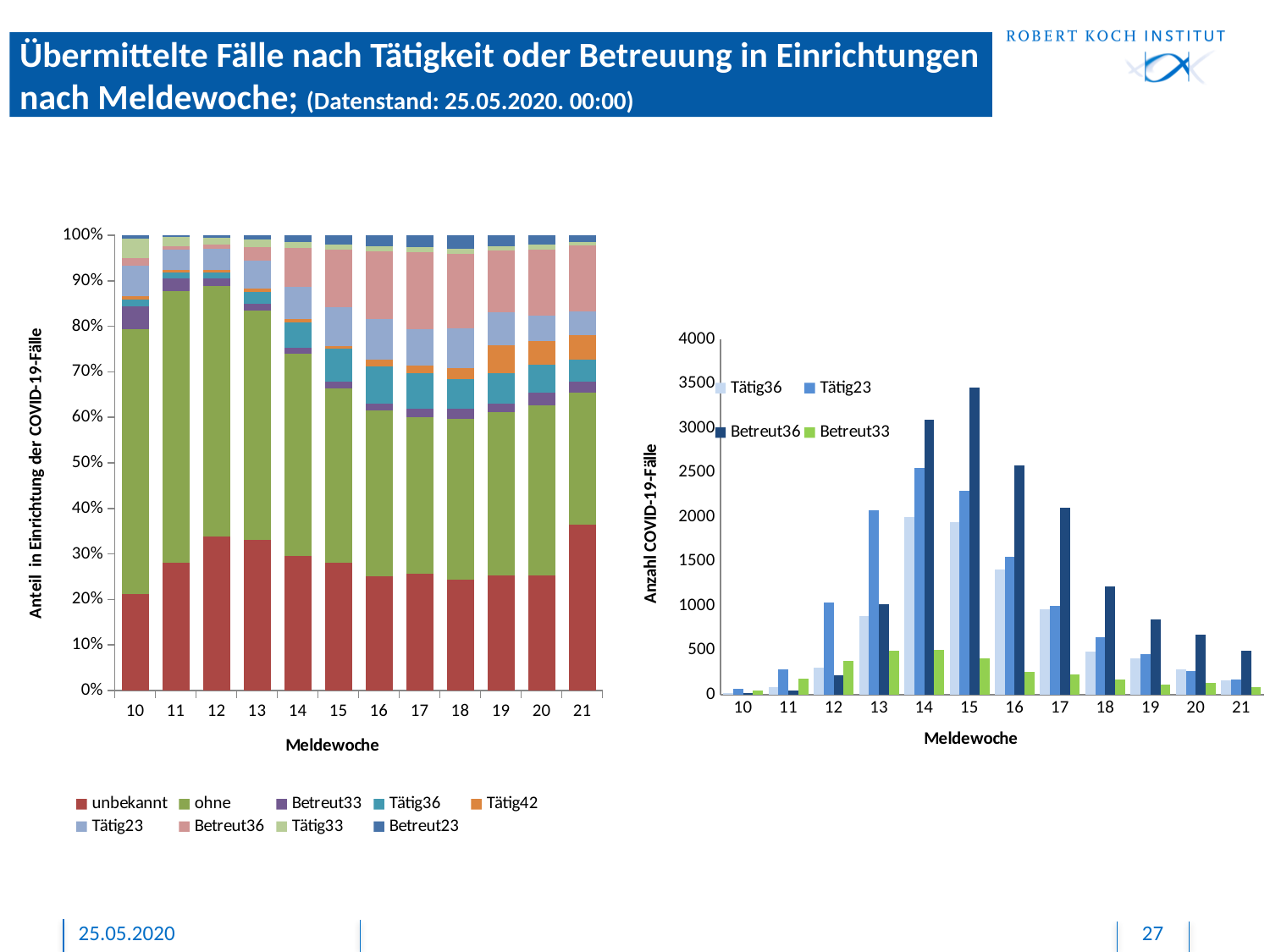
In the right-hand chart, in which Meldewoche is the value for Tätig23 highest? 14 What kind of chart is the chart on the left of the slide (Anteil in Einrichtung der COVID-19-Fälle)? stacked bar chart In the right-hand chart, is the value for Betreut36 in Meldewoche 15 greater or less than 3000? greater How many series does the legend of the right-hand chart (Anzahl COVID-19-Fälle) list? 4 How many Meldewochen (reporting weeks) are shown on the x axis of the right-hand chart? 12 How many series does the legend of the left-hand chart (Anteil in Einrichtung der COVID-19-Fälle) list? 9 In the right-hand chart, is the value for Tätig36 in Meldewoche 14 greater or less than 1500? greater In the left-hand chart, is the share for unbekannt in Meldewoche 21 greater or less than 30%? greater What kind of chart is the chart on the right of the slide (Anzahl COVID-19-Fälle)? bar chart In the right-hand chart, do the values for Betreut36 rise or fall from Meldewoche 15 to Meldewoche 21? fall In the right-hand chart, which is larger in Meldewoche 12: Tätig23 or Betreut36? Tätig23 In the right-hand chart, in which Meldewoche is the value for Betreut36 highest? 15